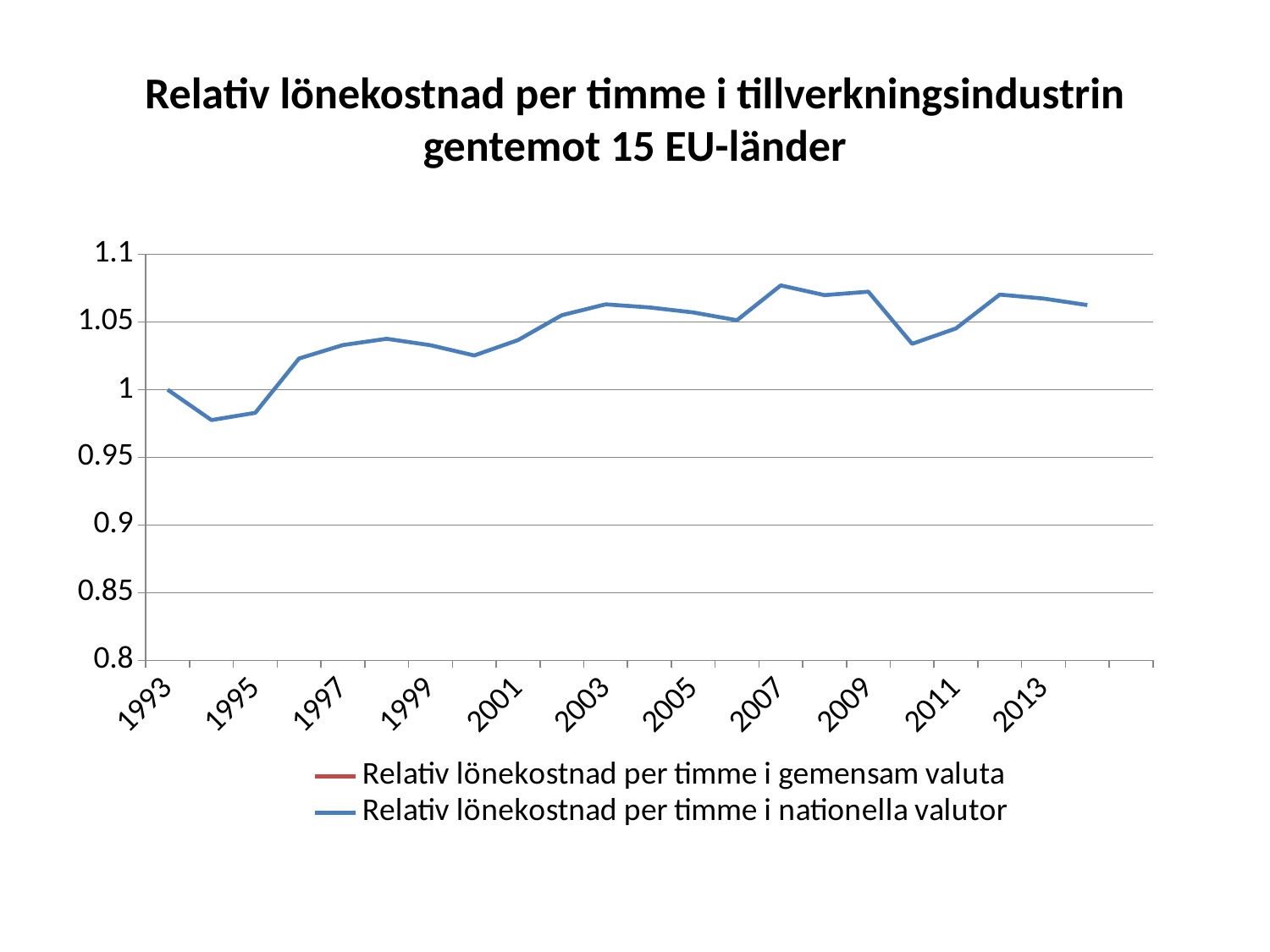
Is the value for 1997 greater or less than 1? greater Which year has the larger value, 1993 or 1994? 1993 Overall, does the plotted line rise or fall from 1993 to the end of the series? rise What kind of chart is shown on the slide? line chart Which year has the larger value, 2007 or 2010? 2007 Is the value for 1994 greater or less than 1? less Is the value for 2010 greater or less than 1.05? less What is the value of the plotted line in 1993? 1 What is the title of the chart? Relativ lönekostnad per timme i tillverkningsindustrin gentemot 15 EU-länder How many series does the legend list? 2